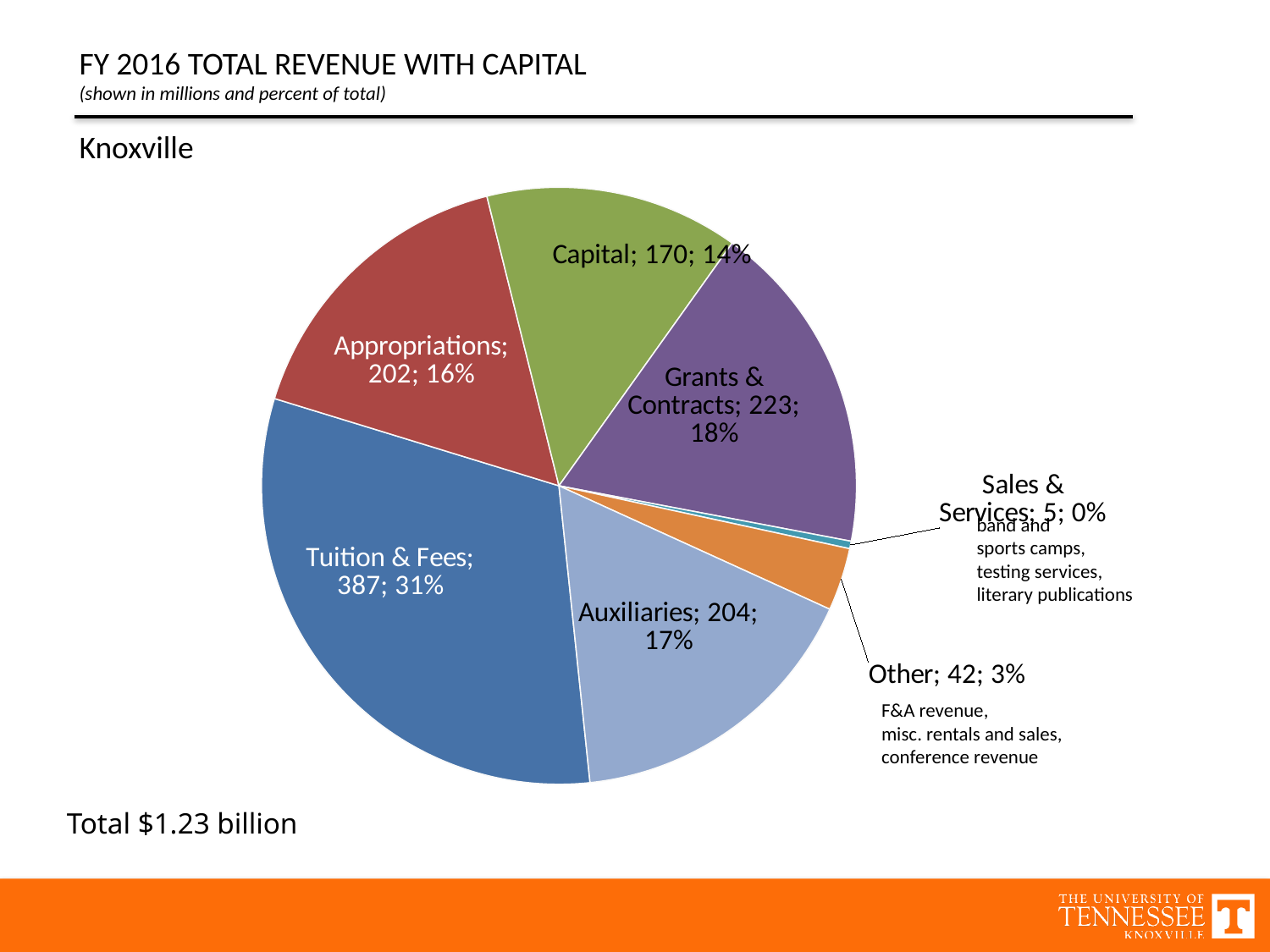
What percent of the total does Appropriations represent? 16% What is the value shown for Capital? 170 Which is larger, the value for Appropriations or the value for Capital? Appropriations What is the value shown for Grants & Contracts? 223 What kind of chart is shown on the slide? pie chart How many slices does the pie chart have? 7 Which category has the smallest slice of the pie? Sales & Services What percent of the total does Auxiliaries represent? 17% What is the title of the chart? FY 2016 TOTAL REVENUE WITH CAPITAL What is the difference between the values for Tuition & Fees and Grants & Contracts? 164 What is the value shown for Tuition & Fees? 387 Which category has the largest slice of the pie? Tuition & Fees